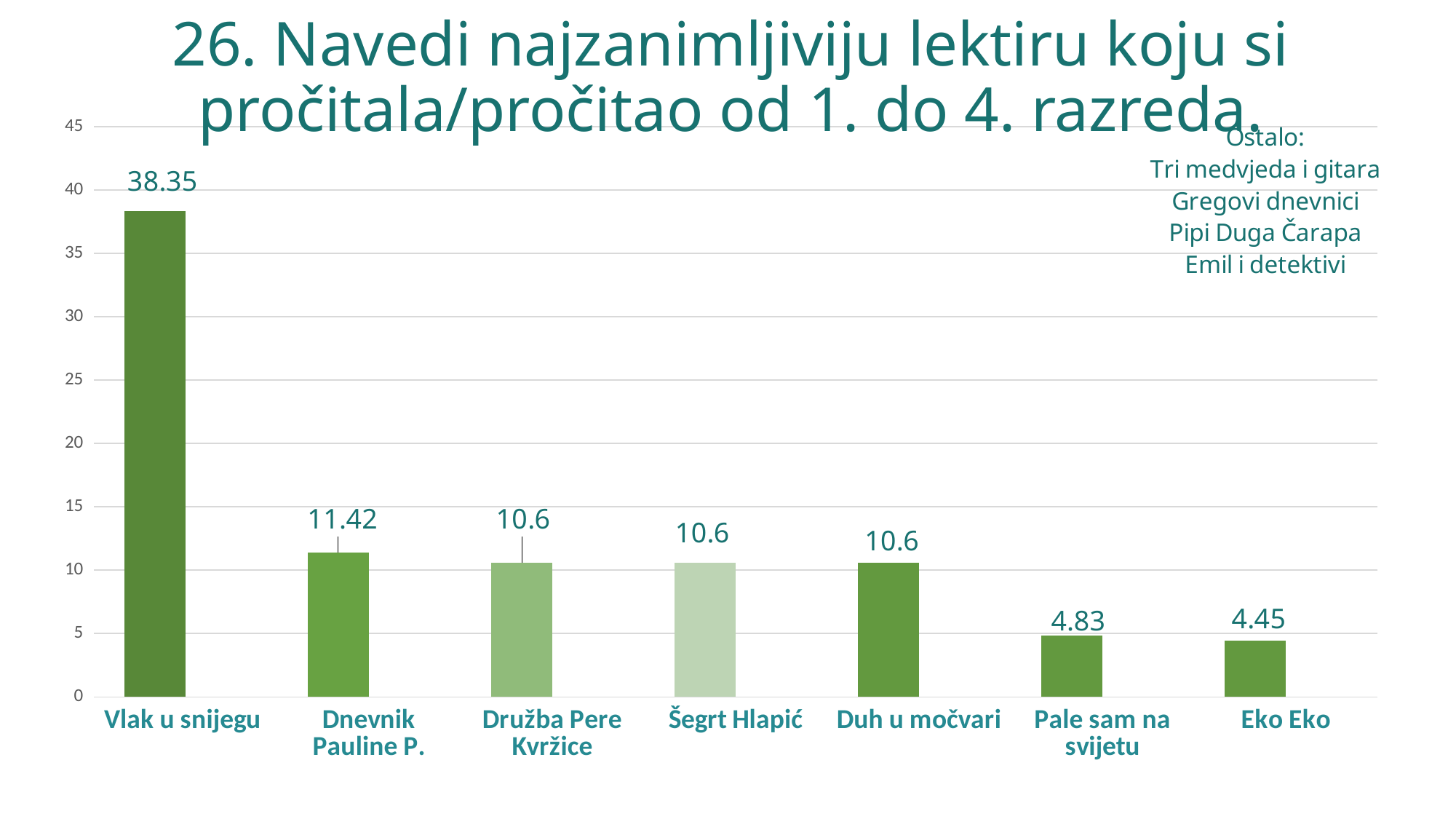
What is the difference between the values for Pale sam na svijetu and Eko Eko? 0.38 Is the value for Vlak u snijegu greater or less than 35? greater Which category has the lowest value? Eko Eko What is the value for Pale sam na svijetu? 4.83 What is the value for Eko Eko? 4.45 Which category has the highest value? Vlak u snijegu What is the value for Dnevnik Pauline P.? 11.42 What kind of chart is shown on the slide? bar chart What is the difference between the values for Vlak u snijegu and Dnevnik Pauline P.? 26.93 What is the value for Vlak u snijegu? 38.35 How many categories are shown on the x axis? 7 Which is larger, the value for Dnevnik Pauline P. or the value for Šegrt Hlapić? Dnevnik Pauline P.